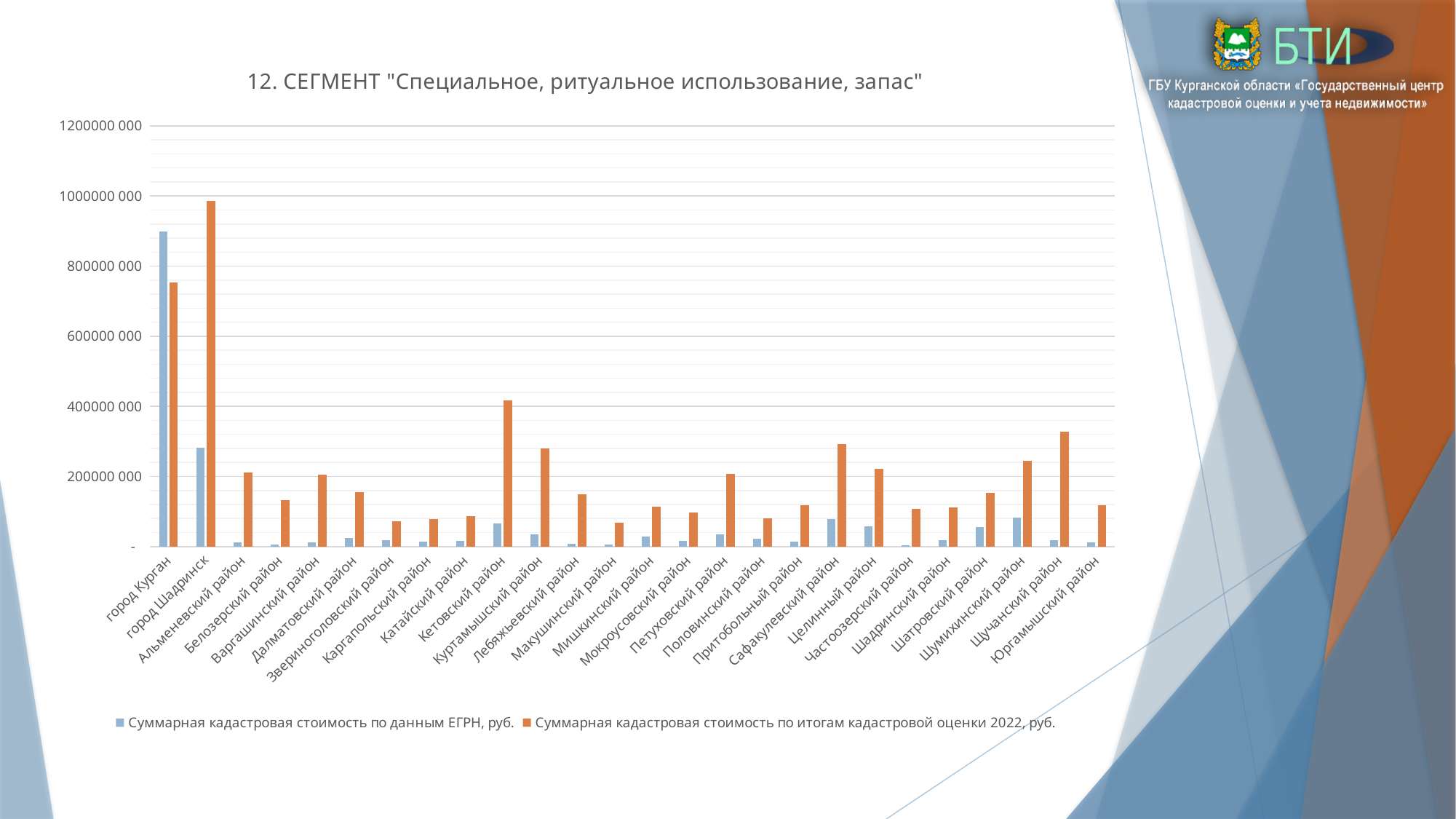
Which is larger in the series "Суммарная кадастровая стоимость по итогам кадастровой оценки 2022, руб.": Кетовский район or Куртамышский район? Кетовский район Which category has the highest value for the series "Суммарная кадастровая стоимость по данным ЕГРН, руб."? город Курган Which category has the highest value for the series "Суммарная кадастровая стоимость по итогам кадастровой оценки 2022, руб."? город Шадринск Is the value for город Курган in the series "Суммарная кадастровая стоимость по итогам кадастровой оценки 2022, руб." greater or less than 600000 000? greater Is the value for Щучанский район in the series "Суммарная кадастровая стоимость по итогам кадастровой оценки 2022, руб." greater or less than 200000 000? greater Is the value for Белозерский район in the series "Суммарная кадастровая стоимость по итогам кадастровой оценки 2022, руб." greater or less than 200000 000? less For город Шадринск, which series has the larger value: "Суммарная кадастровая стоимость по данным ЕГРН, руб." or "Суммарная кадастровая стоимость по итогам кадастровой оценки 2022, руб."? Суммарная кадастровая стоимость по итогам кадастровой оценки 2022, руб. What is the title of the chart? 12. СЕГМЕНТ "Специальное, ритуальное использование, запас" How many categories are shown on the x axis? 26 How many series does the legend list? 2 For город Курган, which series has the larger value: "Суммарная кадастровая стоимость по данным ЕГРН, руб." or "Суммарная кадастровая стоимость по итогам кадастровой оценки 2022, руб."? Суммарная кадастровая стоимость по данным ЕГРН, руб. What kind of chart is shown on the slide? bar chart